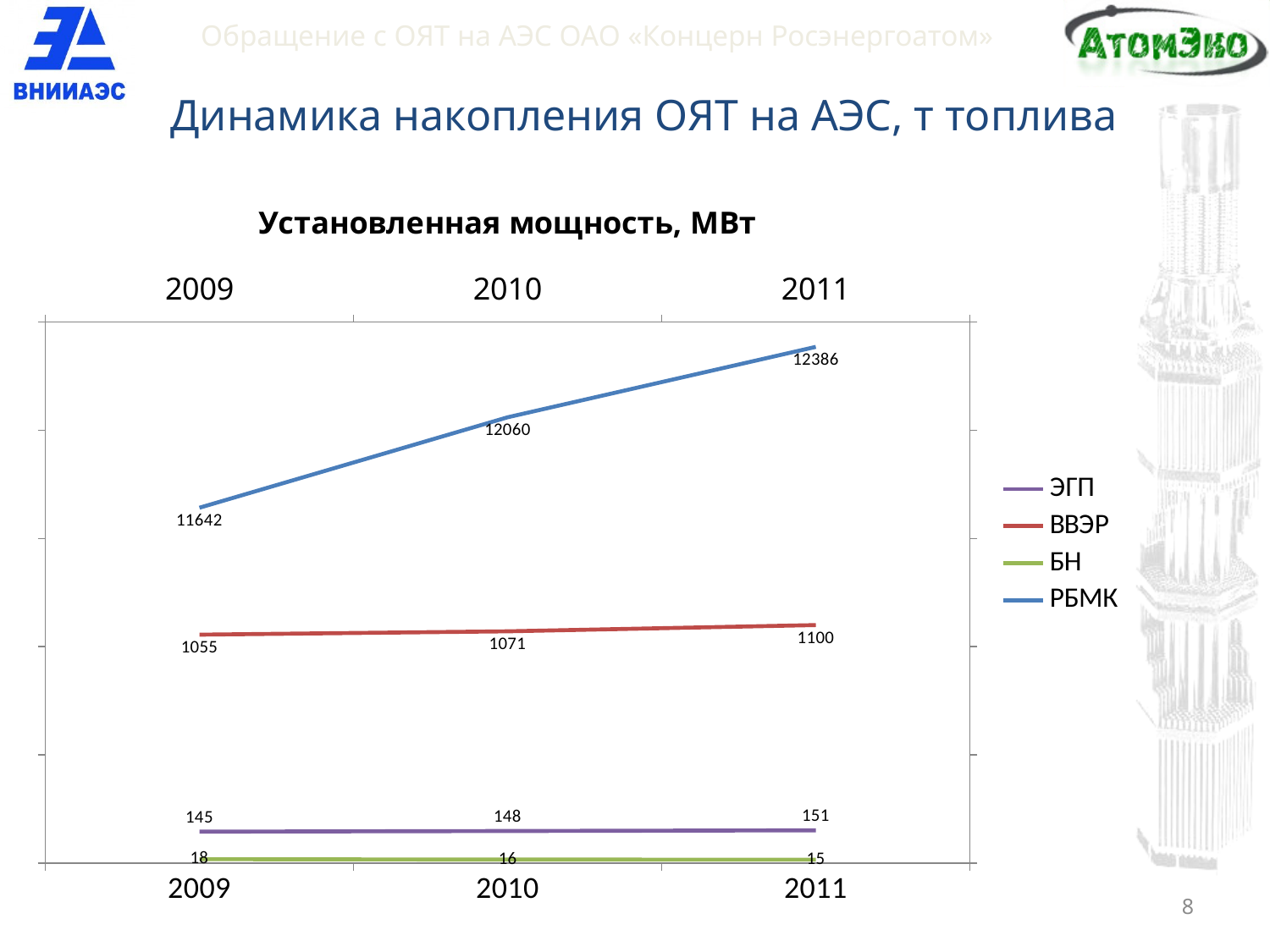
What is the value for РБМК in 2011? 12386 Which series has the lowest values in the chart? БН What is the value for ЭГП in 2010? 148 What is the value for ВВЭР in 2009? 1055 What is the difference between the РБМК values for 2011 and 2009? 744 Do the values for БН rise or fall from 2009 to 2011? fall Which series has the highest values in the chart? РБМК How many series does the legend list? 4 What type of chart is shown on the slide? line chart Which is larger: the ВВЭР value in 2011 or the ВВЭР value in 2010? 2011 What is the title of the chart? Установленная мощность, МВт What is the value for БН in 2011? 15